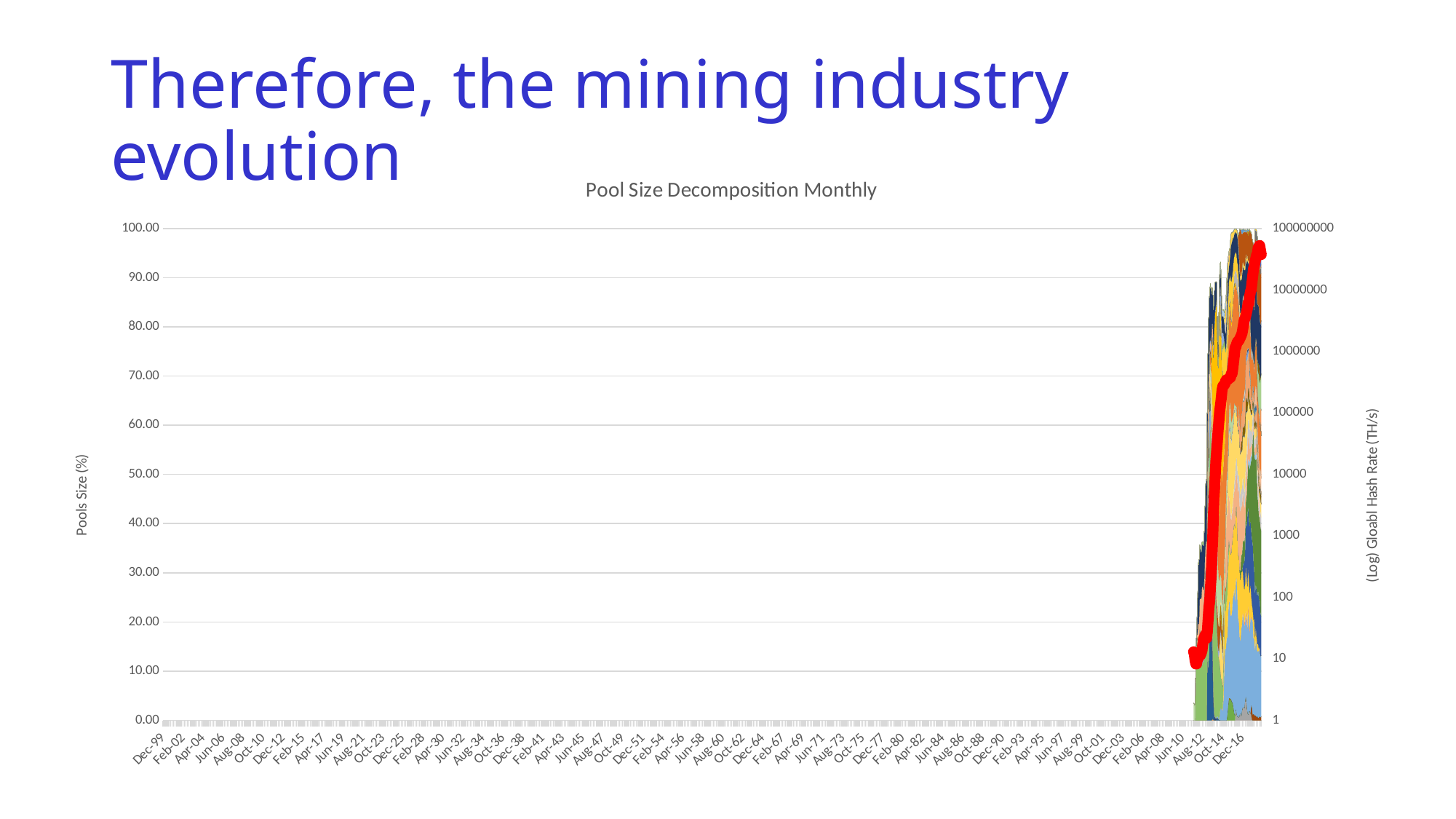
What is the title of the chart? Pool Size Decomposition Monthly Is the value of the red line at its left-hand start greater or less than 100 on the right axis? less What kind of chart is shown on the slide? stacked area chart with a line overlay Does the red line rise or fall as it moves from left to right along the x axis? rise What is the label of the left vertical axis? Pools Size (%) Is the value of the red line at its right-hand end greater or less than 1000000 on the right axis? greater